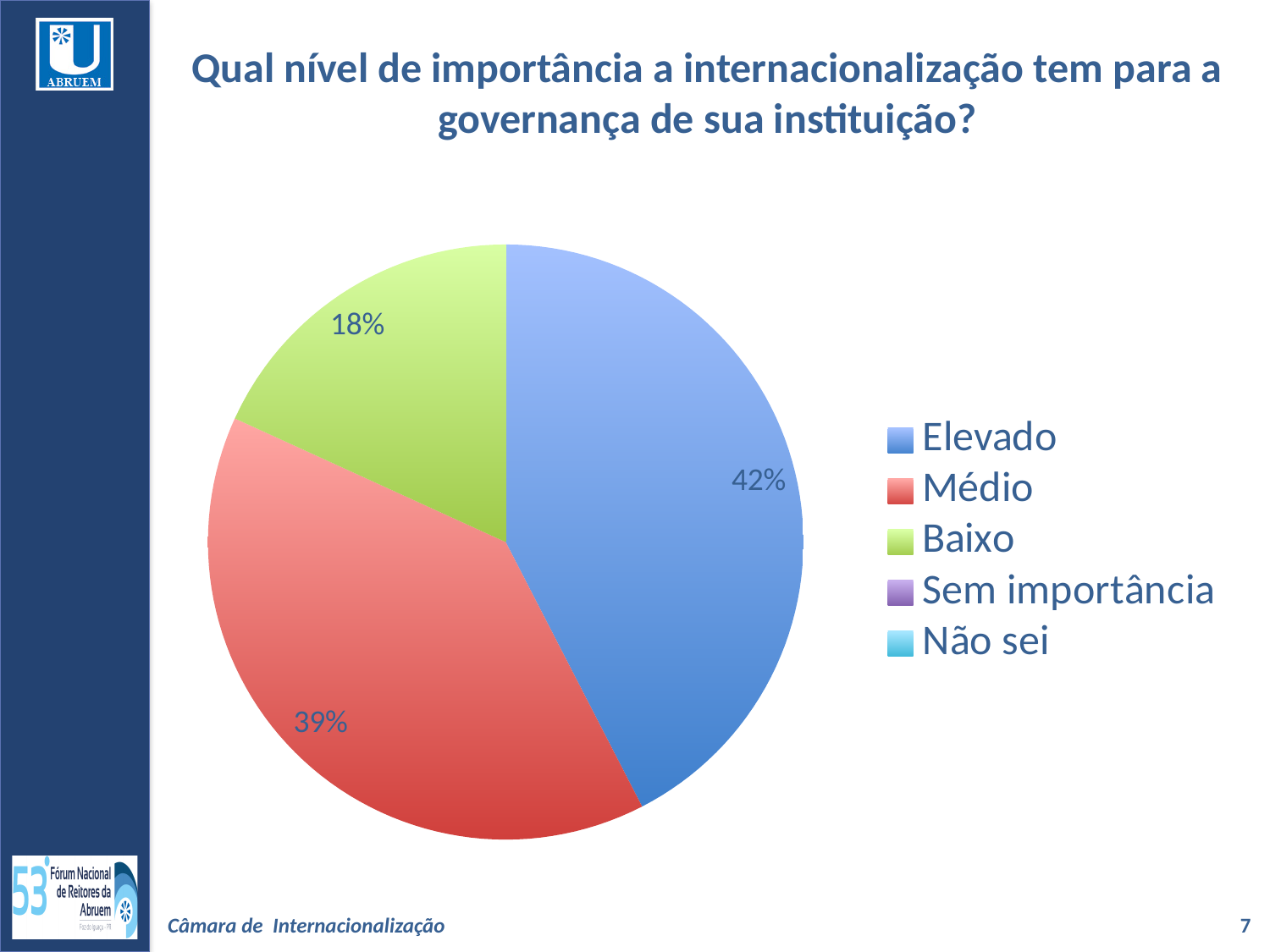
What kind of chart is shown on the slide? pie chart Which of the labelled slices is the smallest? Baixo What is the difference in percentage points between Elevado and Médio? 3% Which is larger, the slice for Médio or the slice for Baixo? Médio What share of the pie does Médio have? 39% Which category has the largest slice of the pie? Elevado What share of the pie does Elevado have? 42% What colour is the Médio slice? red What share of the pie does Baixo have? 18% What is the difference in percentage points between Médio and Baixo? 21% How many entries does the legend list? 5 Which legend entry is listed last? Não sei